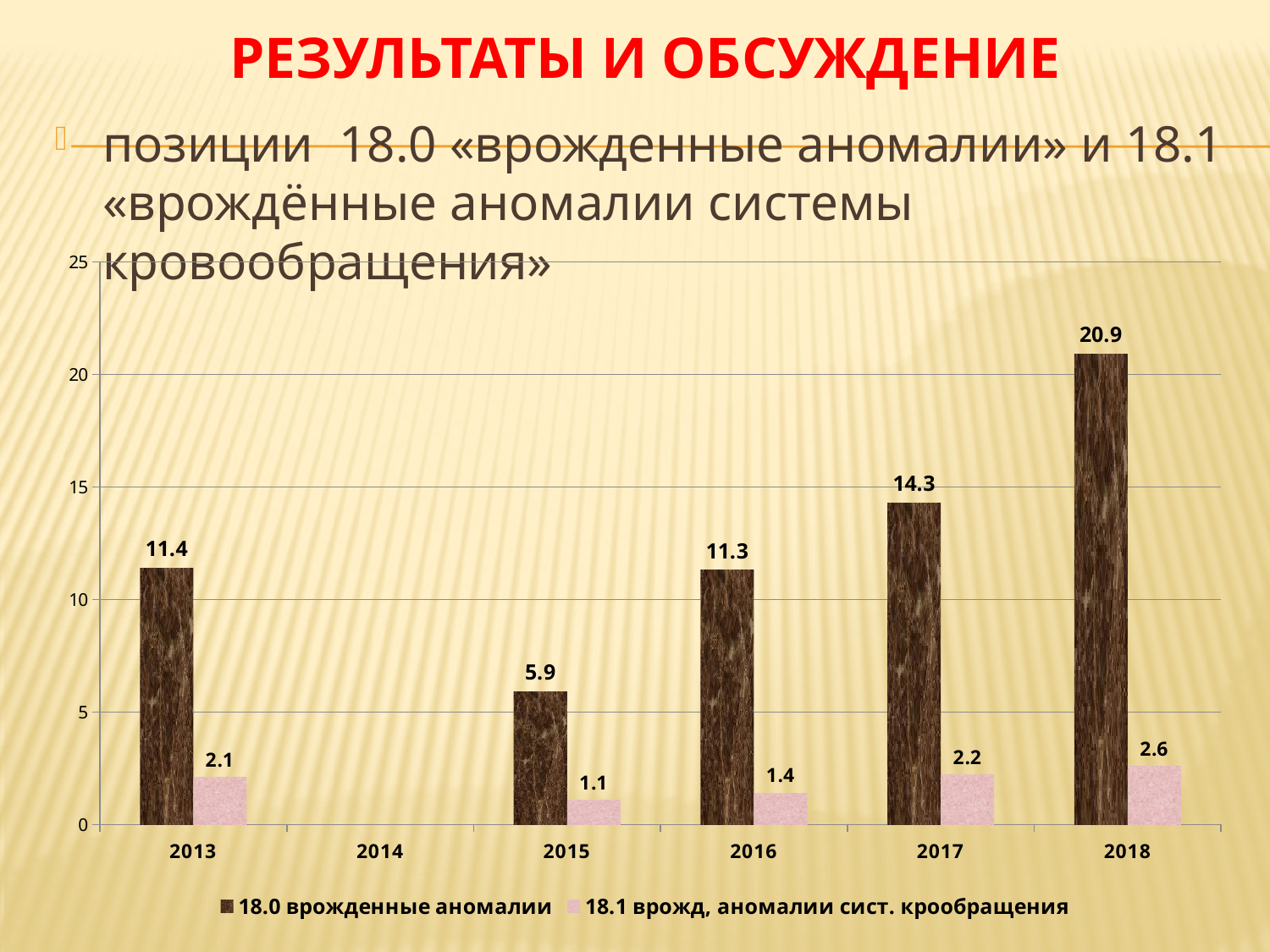
Is the value for 2016 in the series "18.0 врожденные аномалии" greater or less than 10? greater How many series does the legend list? 2 Which year has the lowest value in the series "18.1 врожд, аномалии сист. крообращения" among the years with bars? 2015 What is the value for 2015 in the series "18.1 врожд, аномалии сист. крообращения"? 1.1 What is the value for 2017 in the series "18.0 врожденные аномалии"? 14.3 Which is larger in the series "18.0 врожденные аномалии": the value for 2013 or the value for 2015? 2013 What kind of chart is shown on the slide? bar chart How many years are shown on the x axis? 6 Which year has the highest value in the series "18.0 врожденные аномалии"? 2018 What is the difference between the 2018 and 2017 values in the series "18.0 врожденные аномалии"? 6.6 What is the value for 2018 in the series "18.0 врожденные аномалии"? 20.9 Which year on the x axis has no bars plotted? 2014